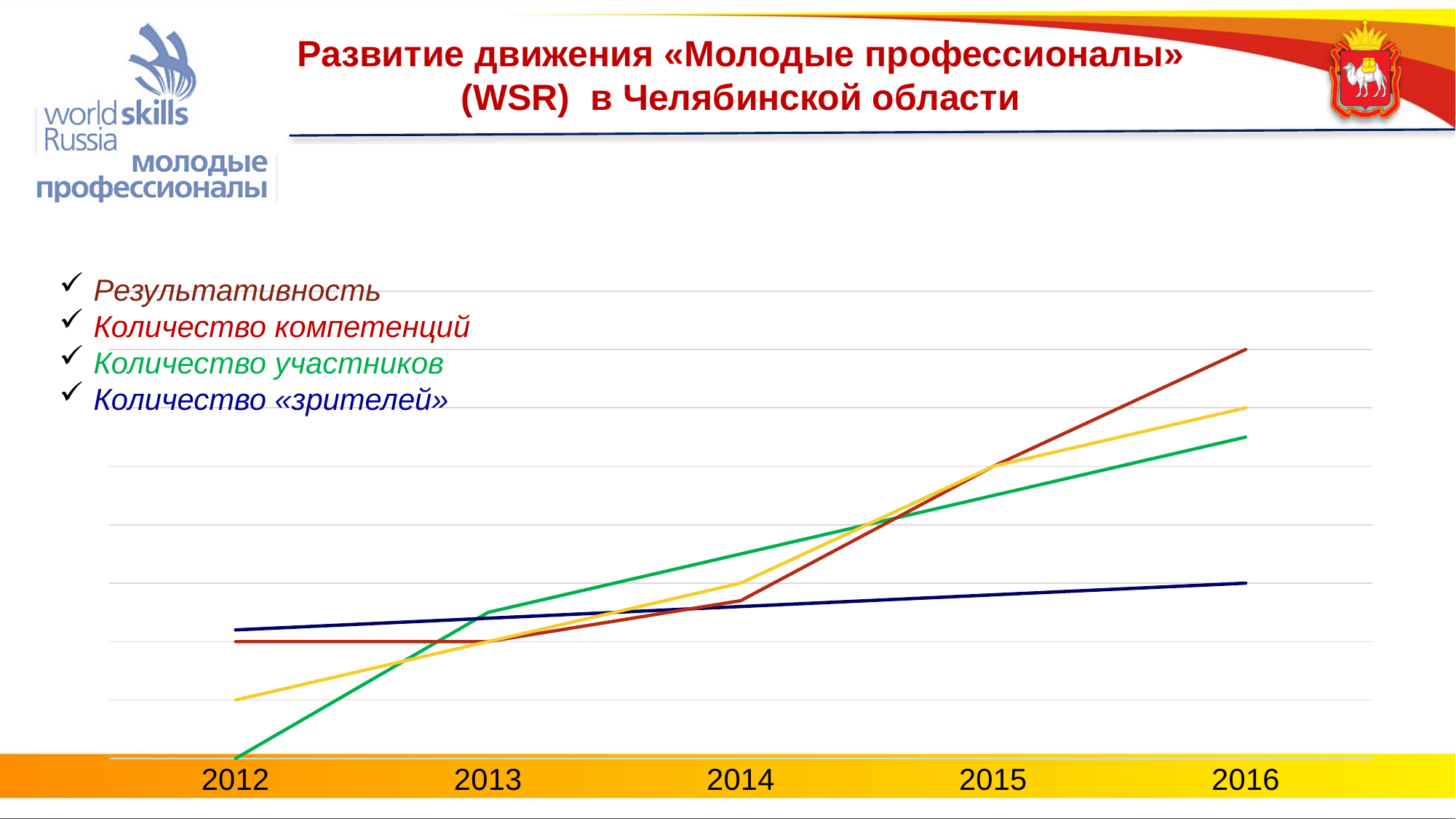
How many lines are plotted on the chart? 4 What kind of chart is shown on the slide? line chart What is the first year shown on the x axis of the chart? 2012 Does the dark blue line (Количество «зрителей») rise or fall from 2012 to 2016? rises How many years are shown along the x axis of the chart? 5 Which line is the lowest at 2016? the dark blue line (Количество «зрителей») What is the last year shown on the x axis of the chart? 2016 Which line is the highest at 2016? the dark red line Which line is the lowest at 2012? the green line (Количество участников) At 2016, which is higher: the green line (Количество участников) or the dark blue line (Количество «зрителей»)? the green line (Количество участников) What is the title of the slide containing the chart? Развитие движения «Молодые профессионалы» (WSR) в Челябинской области Does the green line (Количество участников) rise or fall from 2012 to 2016? rises